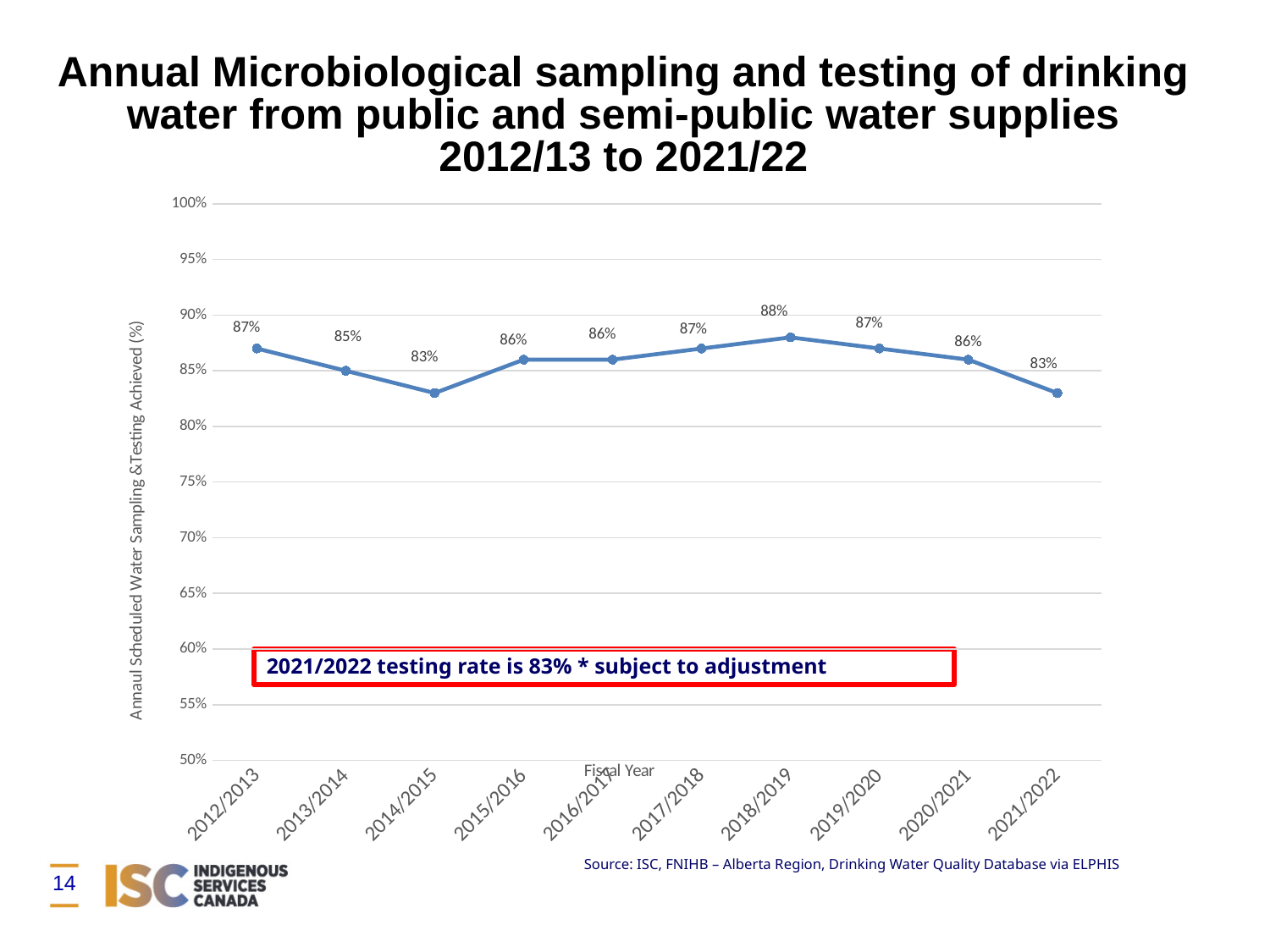
Did the testing rate rise or fall from 2018/2019 to 2021/2022? fall What is the label of the x axis? Fiscal Year What was the testing rate achieved in 2014/2015? 83% What is the difference between the testing rate in 2018/2019 and in 2021/2022? 5% Which fiscal year had a higher testing rate, 2013/2014 or 2017/2018? 2017/2018 What type of chart is shown on the slide? line chart What is the lowest testing rate shown on the chart? 83% How many fiscal years are plotted on the chart? 10 What was the testing rate achieved in 2021/2022? 83% What was the testing rate achieved in 2018/2019? 88% Which fiscal year had the highest testing rate? 2018/2019 What was the testing rate achieved in 2012/2013? 87%